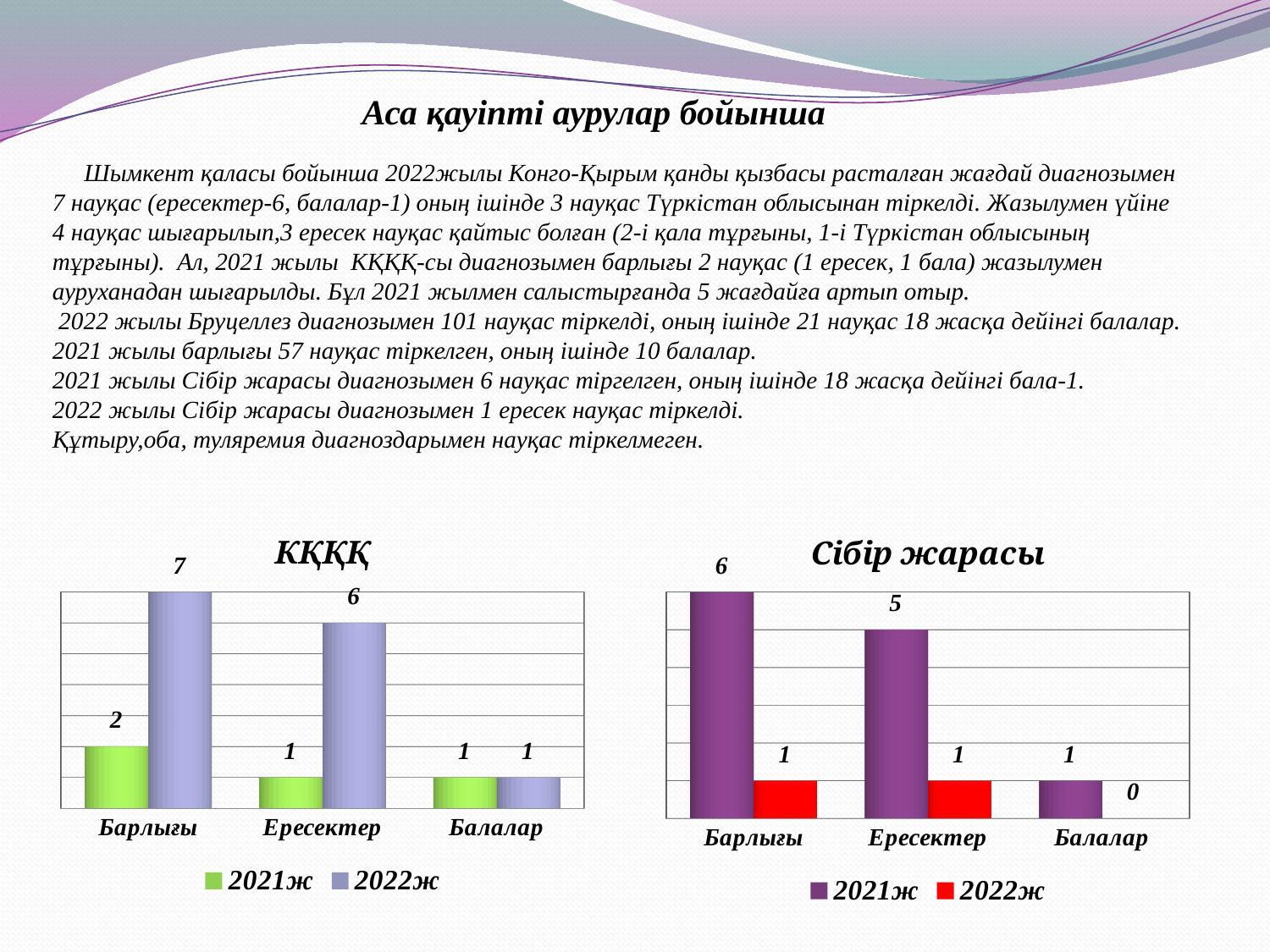
In the КҚҚҚ chart, which category has the highest value in the 2022ж series? Барлығы In the Сібір жарасы chart, which is larger for Барлығы: the 2021ж value or the 2022ж value? 2021ж In the КҚҚҚ chart, what is the value for Ересектер in the 2021ж series? 1 What kind of chart is the КҚҚҚ chart? Bar chart In the КҚҚҚ chart, how many series does the legend list? 2 In the Сібір жарасы chart, what is the difference between the 2021ж and 2022ж values for Ересектер? 4 In the КҚҚҚ chart, what is the value for Барлығы in the 2022ж series? 7 In the Сібір жарасы chart, which category has the lowest value in the 2021ж series? Балалар How many categories are shown on the x axis of the Сібір жарасы chart? 3 In the Сібір жарасы chart, what is the value for Ересектер in the 2021ж series? 5 In the Сібір жарасы chart, what is the value for Балалар in the 2022ж series? 0 In the КҚҚҚ chart, what is the difference between the 2022ж and 2021ж values for Барлығы? 5